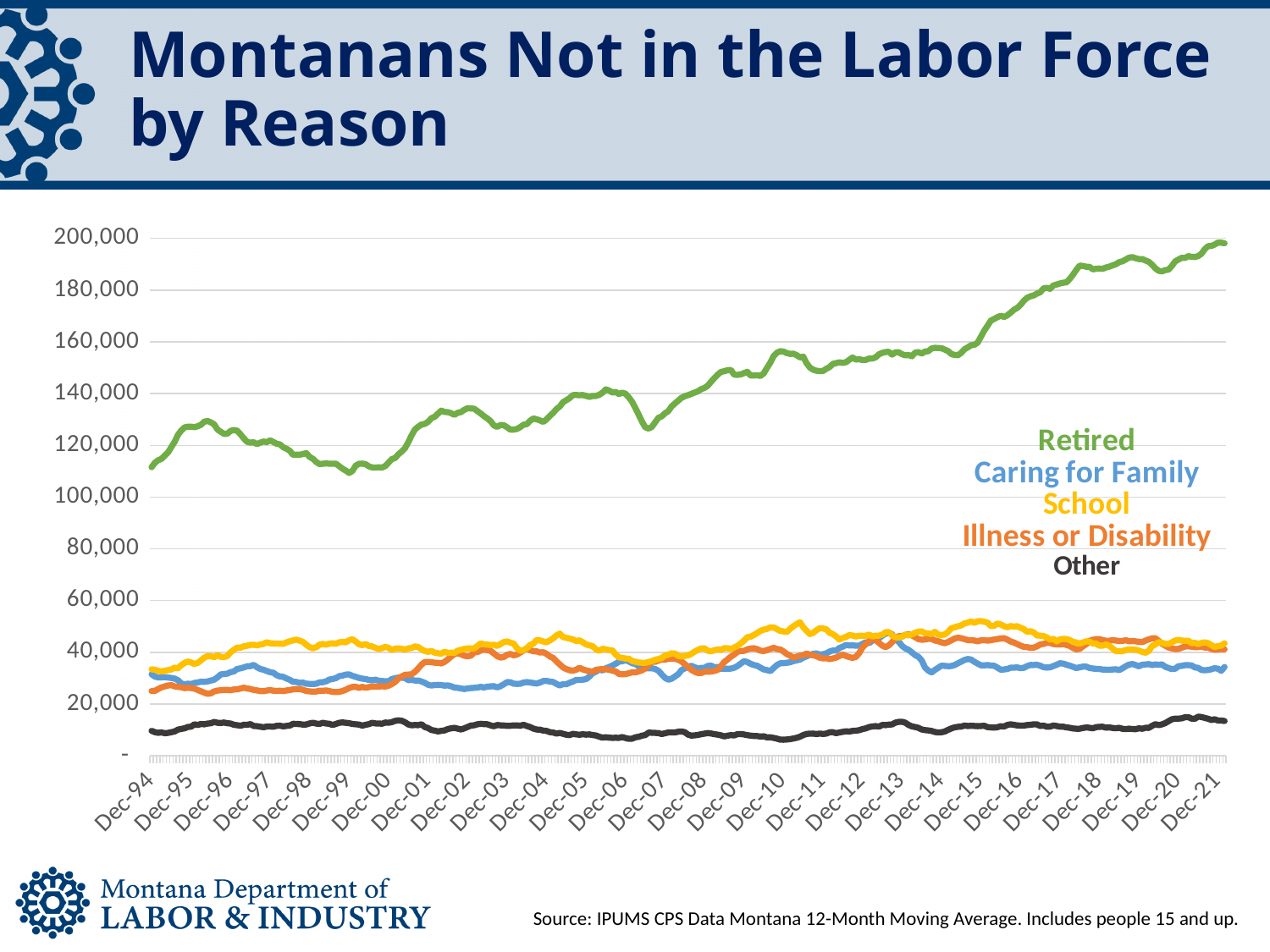
What colour is the Retired line? green Is the value for Other at Dec-21 greater or less than 20,000? less Is the value for Retired at Dec-10 greater or less than 140,000? greater Does the Retired series rise or fall from Dec-94 to Dec-21? rise Is the value for Retired at Dec-21 greater or less than 180,000? greater How many series does the chart show? 5 At Dec-21, which is larger: Caring for Family or Other? Caring for Family What kind of chart is shown on the slide? line chart What is the title of the chart on the slide? Montanans Not in the Labor Force by Reason Which series has the lowest values across the whole chart? Other Which series has the highest values across the whole chart? Retired